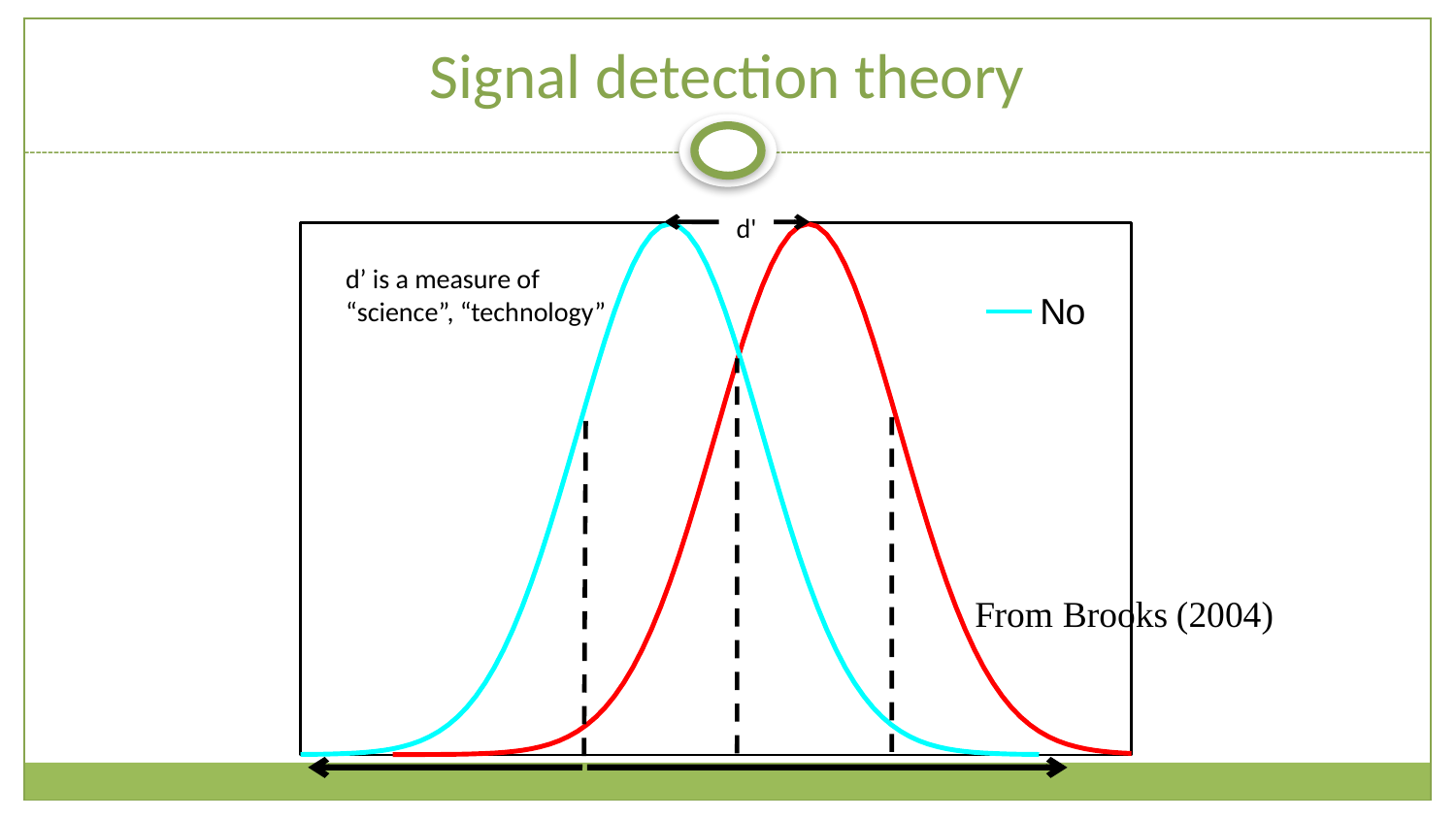
How many curves are plotted on the chart? 2 What kind of chart is shown on the slide? line chart Which curve peaks further to the right, the red curve or the cyan curve? the red curve What is the legend entry shown on the chart? No How many dashed vertical lines are drawn on the chart? 3 How many series does the legend list? 1 What label is written on the arrow between the two curve peaks? d' What colour is the curve labelled "No" in the legend? cyan